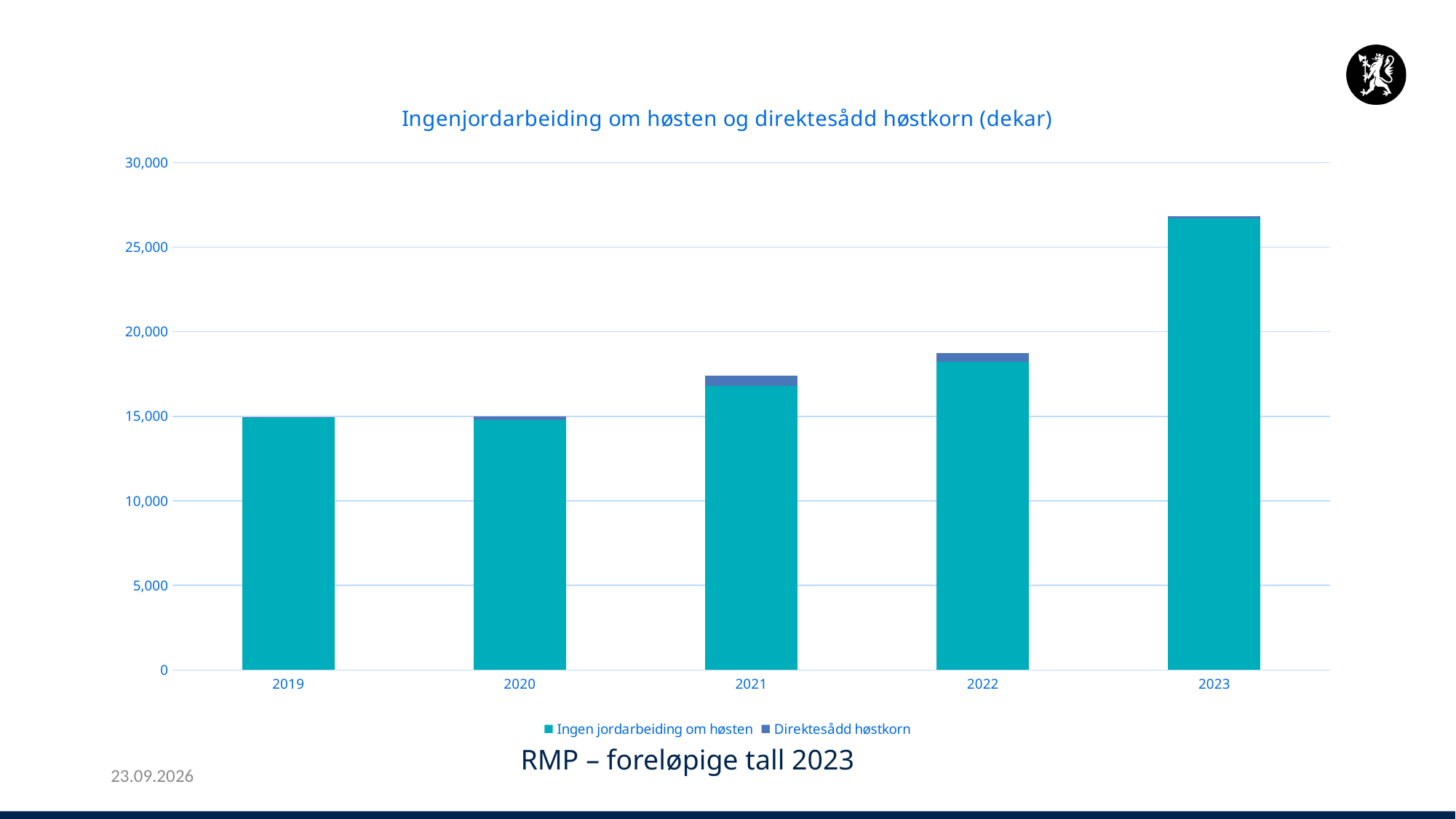
Is the total value for 2019 greater or less than 20,000? less Is the total value for 2023 greater or less than 25,000? greater Which year has the larger total bar, 2022 or 2023? 2023 Which year has the highest total bar? 2023 Is the total value for 2021 greater or less than 15,000? greater How many series does the legend list? 2 Which series is shown in dark blue in the legend? Direktesådd høstkorn How many years are shown on the x axis? 5 What is the title of the chart? Ingenjordarbeiding om høsten og direktesådd høstkorn (dekar) What kind of chart is shown on the slide? bar chart Do the total bar values generally rise or fall from 2019 to 2023? rise